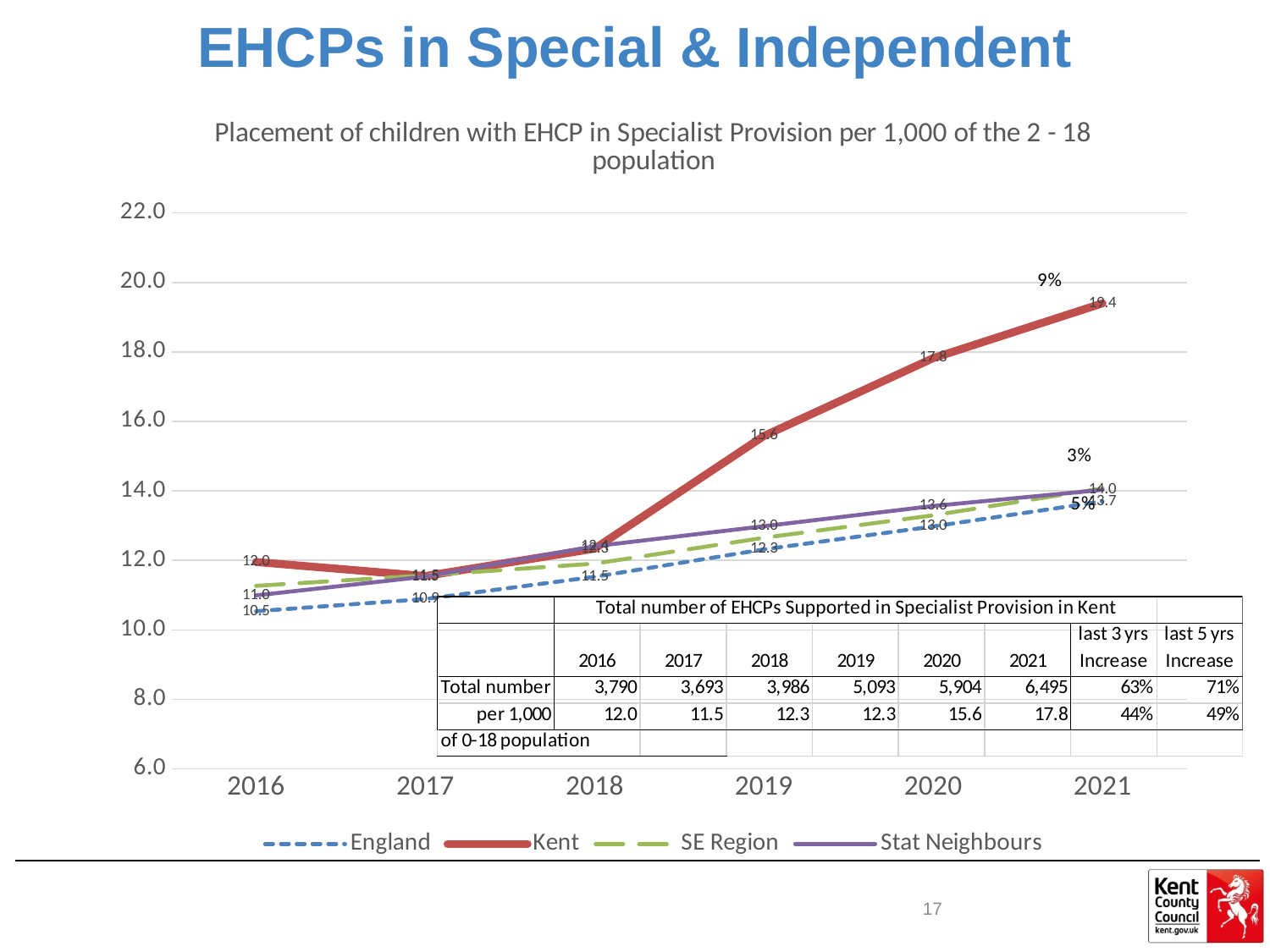
What is the value for England in 2016? 10.5 Which series has the highest value in 2021? Kent Which series has the lowest value in 2016? England What is the value for England in 2021? 13.7 What is the value for Kent in 2019? 15.6 Is the value for Kent in 2021 greater or less than 18.0? greater How many series does the legend list? 4 What is the difference between Kent's value in 2020 and its value in 2019? 2.2 Does the Kent line rise or fall from 2018 to 2021? rise What kind of chart is shown on the slide? line chart How many years are shown along the x axis? 6 What is the value for Kent in 2020? 17.8